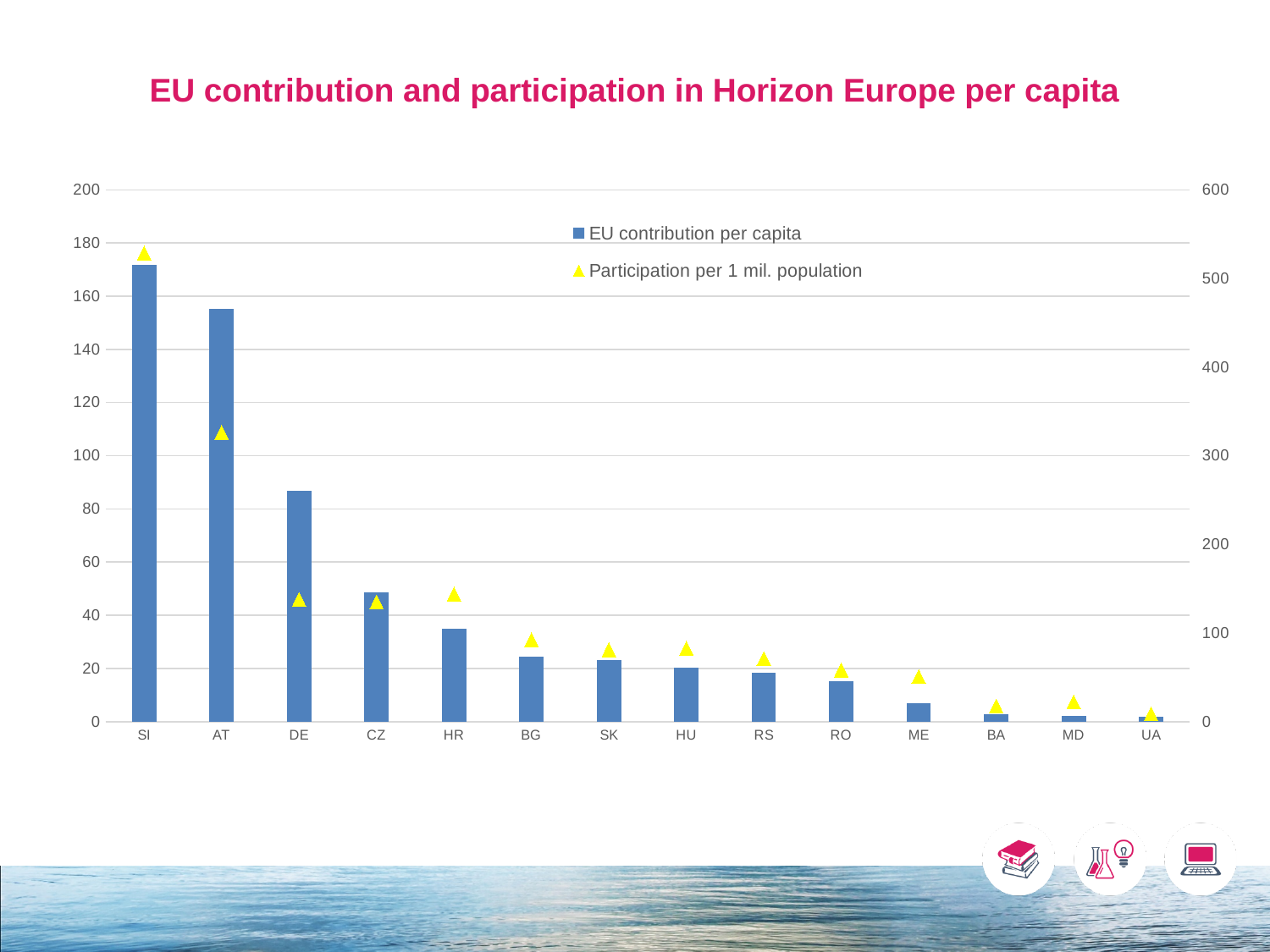
What colour are the EU contribution per capita bars? Blue Which country has the highest EU contribution per capita bar? SI How many countries are shown on the x axis? 14 What is the title of the chart? EU contribution and participation in Horizon Europe per capita Which has the larger EU contribution per capita bar, SI or AT? SI Is the EU contribution per capita bar for AT greater or less than 160? less Is the EU contribution per capita bar for SI greater or less than 160? greater How many series does the legend list? 2 Is the EU contribution per capita bar for DE greater or less than 80? greater Do the EU contribution per capita bars rise or fall from left to right along the x axis? fall Which has the larger EU contribution per capita bar, DE or CZ? DE